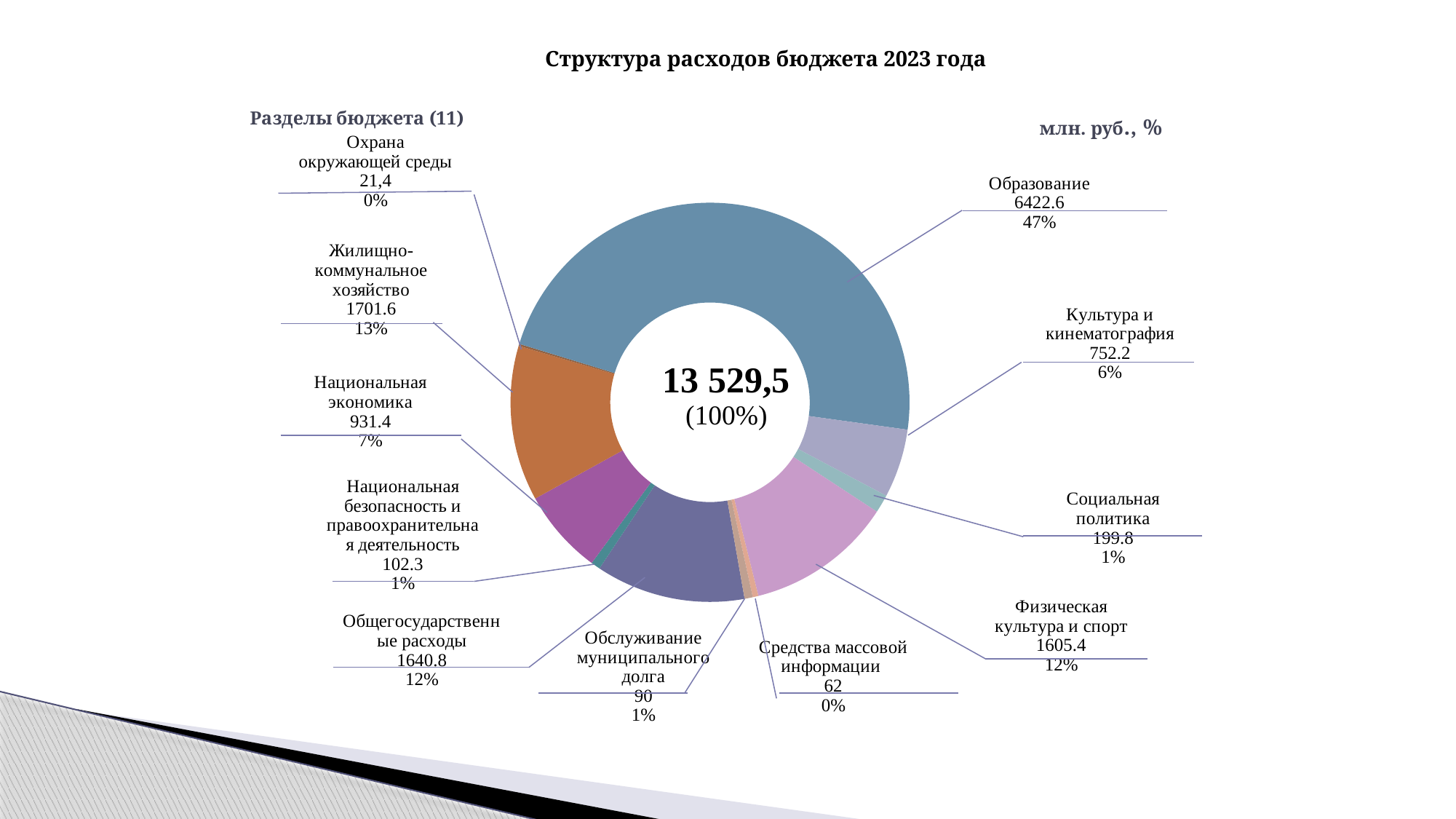
How many categories (sections) are shown in the chart? 11 What type of chart is shown on the slide? Doughnut (pie) chart What percentage share does Образование have in the chart? 47% What is the total value shown in the centre of the chart? 13 529,5 What is the title of the chart? Разделы бюджета (11) What is the value shown for Жилищно-коммунальное хозяйство? 1701.6 What is the difference between the values for Жилищно-коммунальное хозяйство and Общегосударственные расходы? 60.8 Which is larger: Общегосударственные расходы or Национальная экономика? Общегосударственные расходы Which category has the smallest value in the chart? Охрана окружающей среды What is the value shown for Образование? 6422.6 What is the value shown for Физическая культура и спорт? 1605.4 Which category has the largest value in the chart? Образование